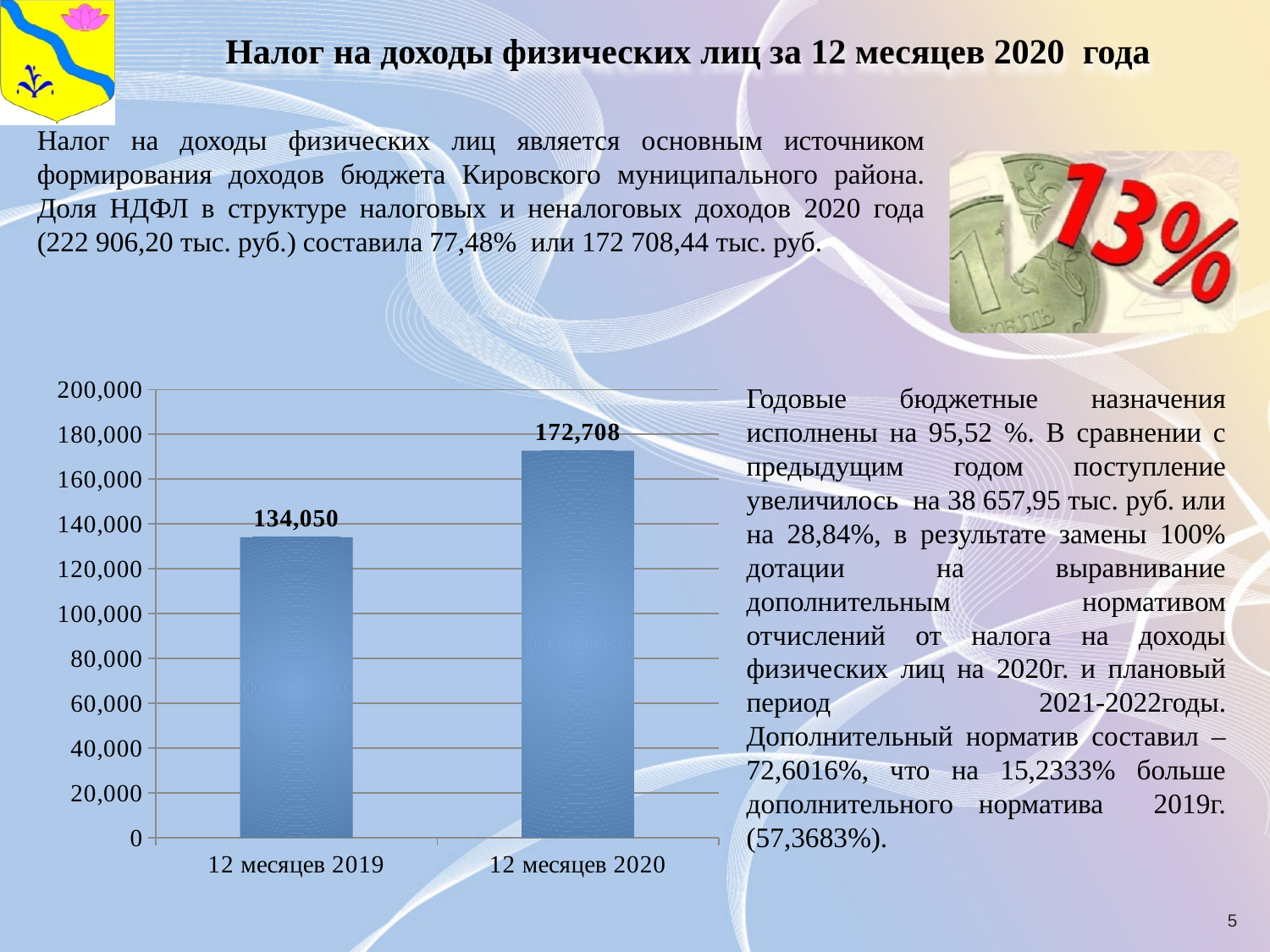
What is the value for 12 месяцев 2020? 172,708 What is the difference between the values for 12 месяцев 2020 and 12 месяцев 2019? 38,658 Is the value for 12 месяцев 2019 greater or less than 140,000? less Which is larger, the value for 12 месяцев 2019 or for 12 месяцев 2020? 12 месяцев 2020 Is the value for 12 месяцев 2020 greater or less than 160,000? greater Do the values rise or fall from 12 месяцев 2019 to 12 месяцев 2020? rise What is the value for 12 месяцев 2019? 134,050 What kind of chart is shown on the slide? bar chart What is the maximum value shown on the vertical axis of the chart? 200,000 Which category has the lowest value? 12 месяцев 2019 How many categories are shown on the chart? 2 Which category has the highest value? 12 месяцев 2020